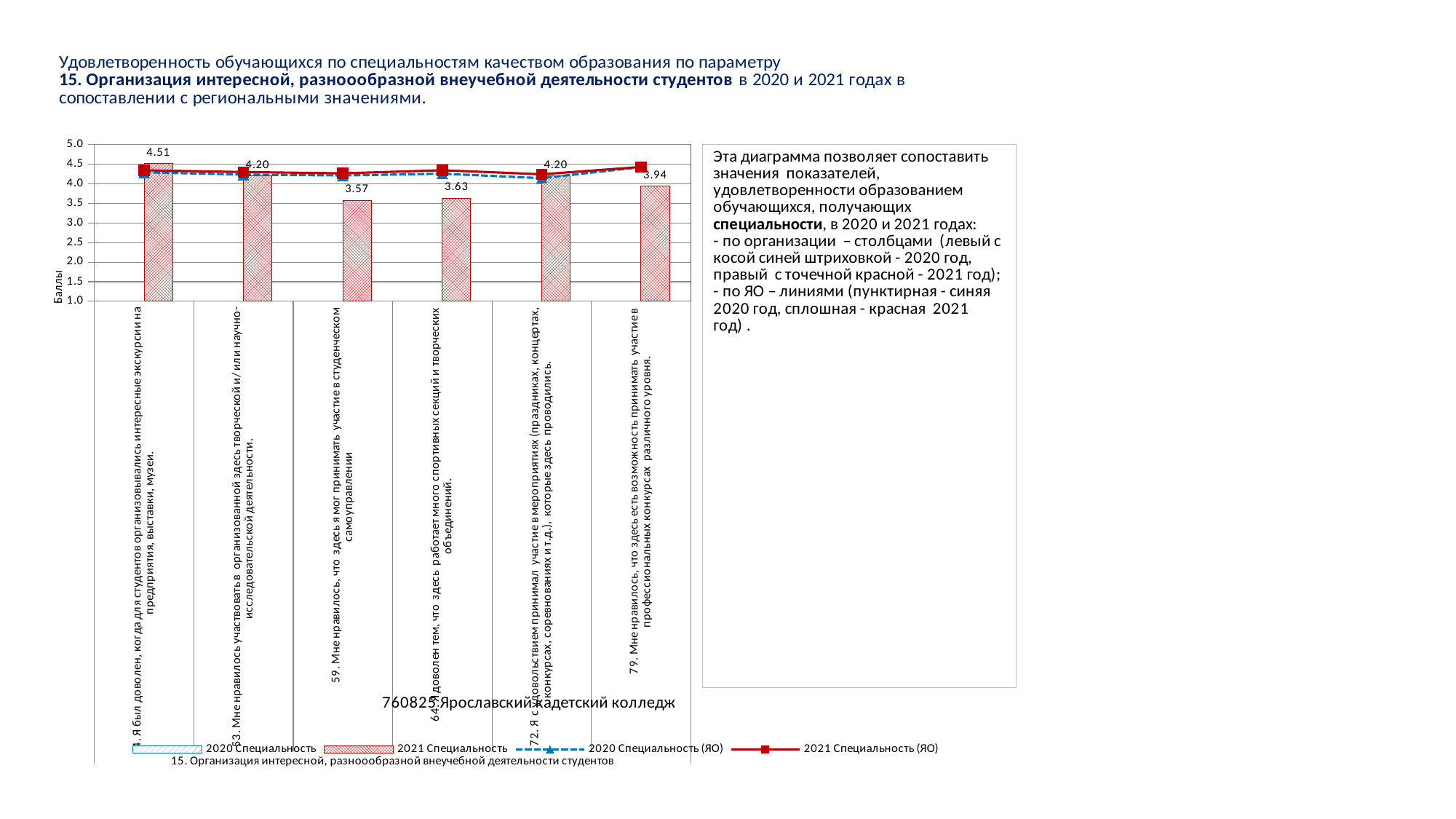
Is the 2021 Специальность (ЯО) line value for category 59 greater or less than 4.0? greater How many series does the chart legend list? 4 What is the difference between the highest 2021 Специальность bar (4.51) and the lowest (3.57)? 0.94 What is the 2021 Специальность value for the category '79. Мне нравилось, что здесь есть возможность принимать участие в профессиональных конкурсах различного уровня'? 3.94 Which 2021 Специальность bar is taller: category 64 (спортивные секции) or category 79 (профессиональные конкурсы)? 79. Мне нравилось, что здесь есть возможность принимать участие в профессиональных конкурсах различного уровня What is the 2021 Специальность value for the category '59. Мне нравилось, что здесь я мог принимать участие в студенческом самоуправлении'? 3.57 What is the title of the vertical axis of the chart? Баллы Which category has the lowest 2021 Специальность bar? 59. Мне нравилось, что здесь я мог принимать участие в студенческом самоуправлении What kind of chart is shown on the slide? bar chart with line series What is the 2021 Специальность value for the category '64. Я доволен тем, что здесь работает много спортивных секций и творческих объединений'? 3.63 Which category has the highest 2021 Специальность bar? 14. Я был доволен, когда для студентов организовывались интересные экскурсии на предприятия, выставки, музеи. How many categories are shown on the x axis of the chart? 6